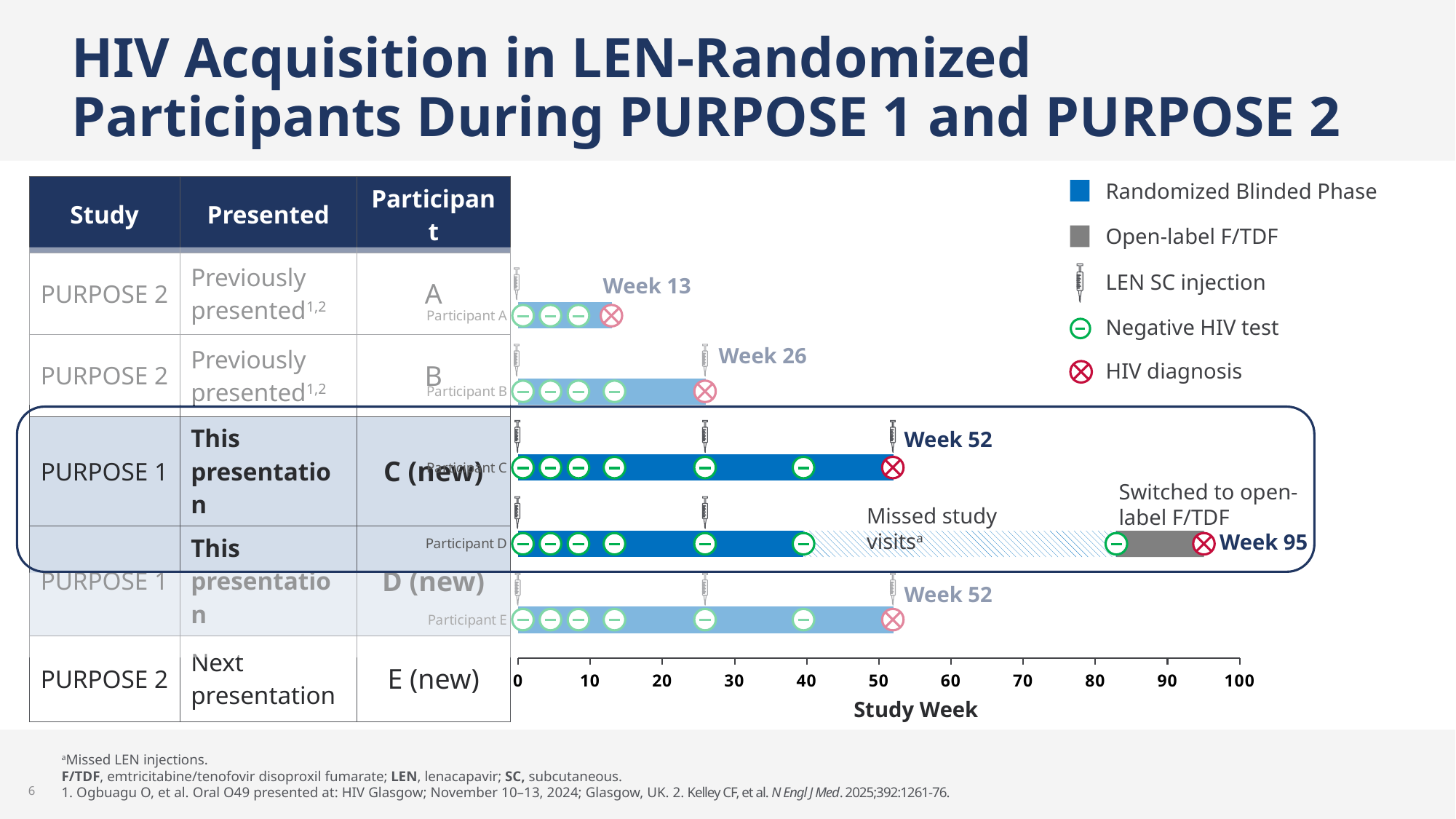
Is the study week of Participant D's HIV diagnosis greater or less than 90? greater At what study week was Participant D diagnosed with HIV? Week 95 How many weeks later was Participant D diagnosed with HIV than Participant C? 43 weeks At what study week was Participant C diagnosed with HIV? Week 52 How many participants are plotted on the timeline? 5 Which participant had the latest HIV diagnosis on the timeline? Participant D Which participant was diagnosed with HIV later, Participant A or Participant B? Participant B What is the title of the x axis of the timeline? Study Week Which participant had the earliest HIV diagnosis on the timeline? Participant A Which participant switched to open-label F/TDF according to the timeline? Participant D At what study week was Participant B diagnosed with HIV? Week 26 At what study week was Participant A diagnosed with HIV? Week 13